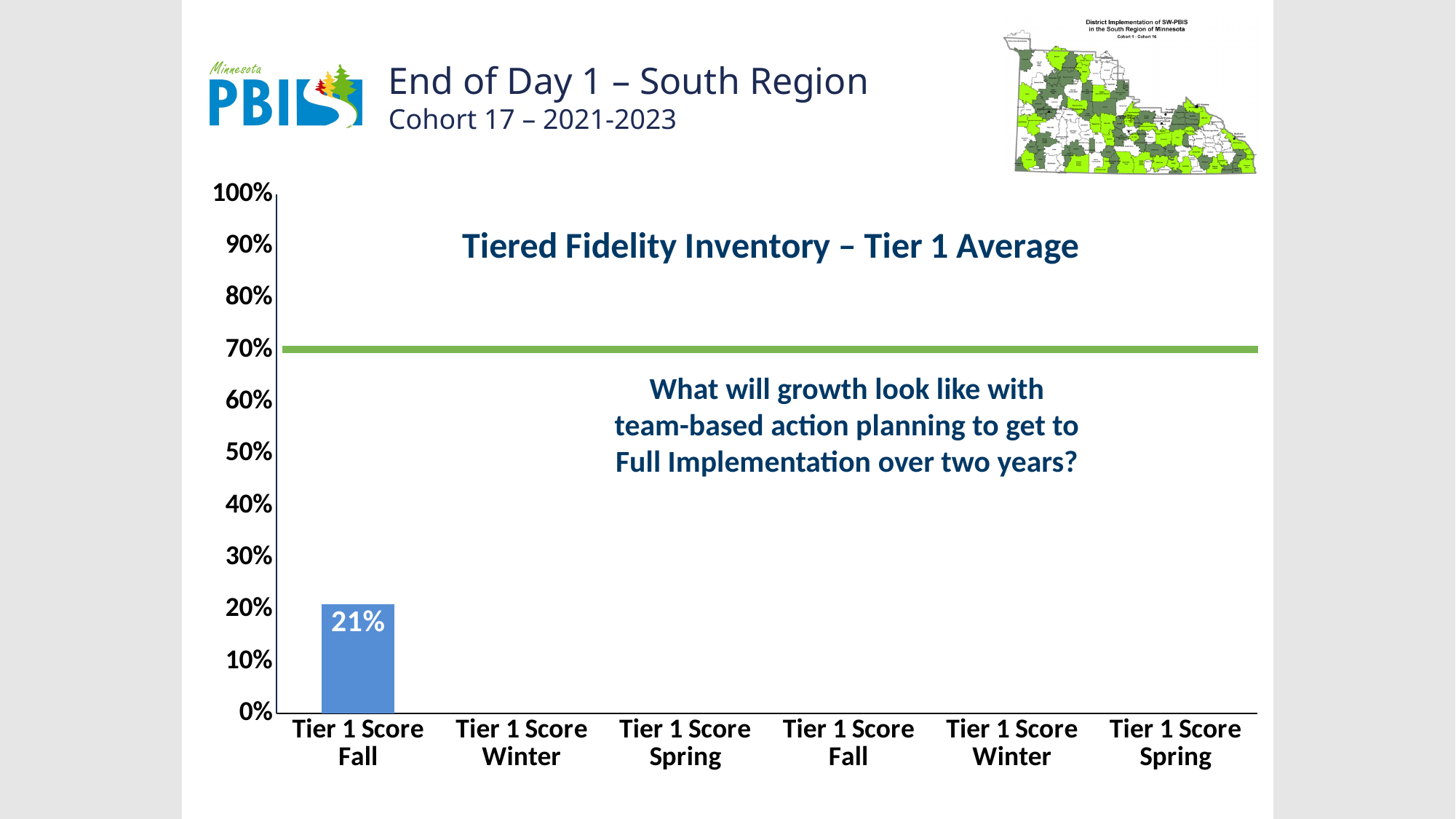
What is the highest value shown on the y axis of the chart? 100% Is the value of the first Tier 1 Score Fall bar greater or less than 30%? less Is the value of the first Tier 1 Score Fall bar greater or less than 20%? greater How many categories are labelled along the x axis of the chart? 6 What is the title of the chart? Tiered Fidelity Inventory – Tier 1 Average At what percentage level is the green horizontal line drawn across the chart? 70% What is the value of the first Tier 1 Score Fall bar? 21% How many bars are plotted on the chart? 1 Is the first Tier 1 Score Fall bar above or below the green 70% line? below Which category has a plotted bar on the chart? Tier 1 Score Fall (first) What kind of chart is shown on the slide? bar chart